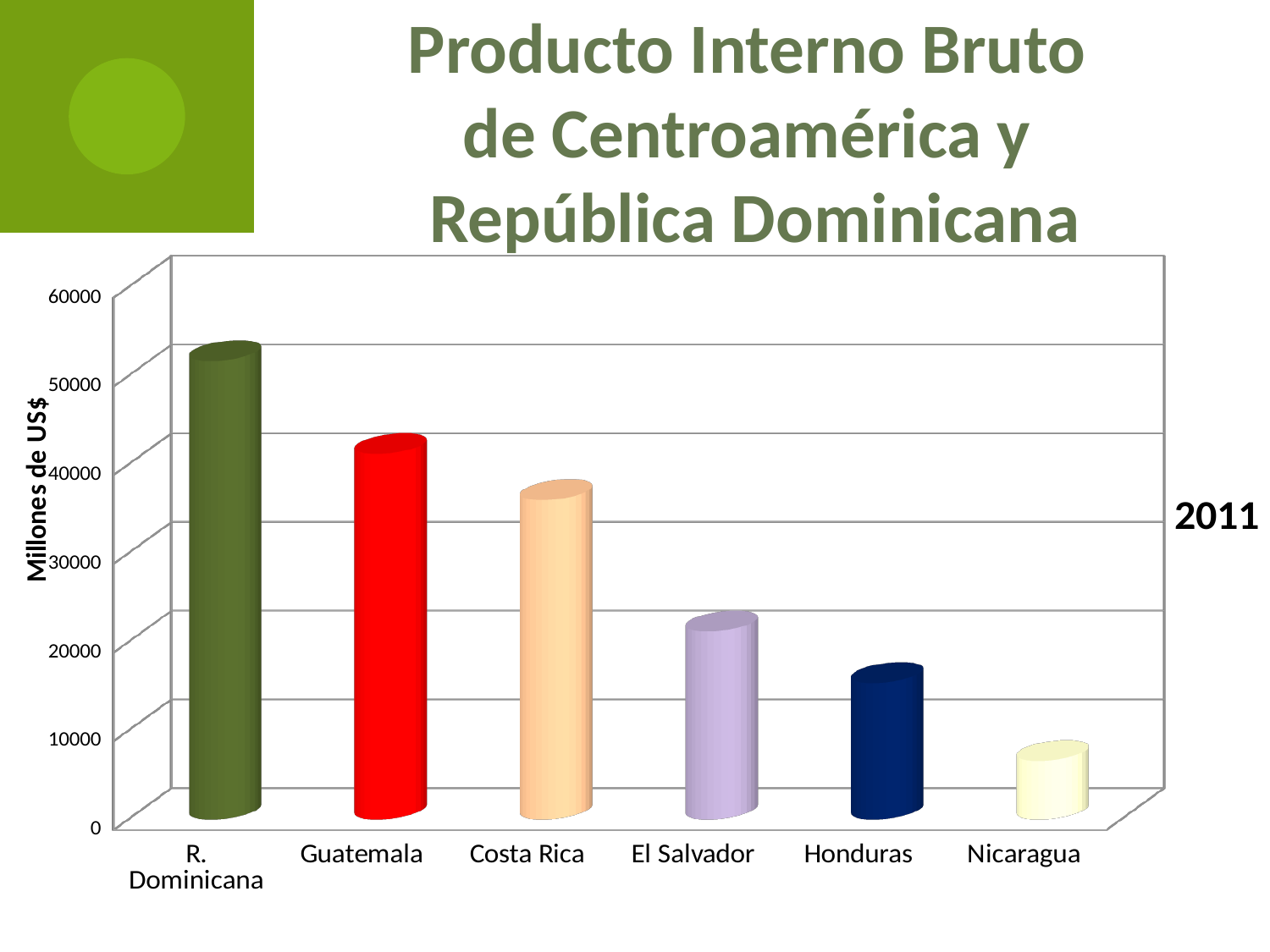
How many countries are shown on the x axis of the chart? 6 Which country has the lowest GDP value in the chart? Nicaragua What year does the legend of the chart show? 2011 Which has the larger value, Guatemala or Costa Rica? Guatemala How many series does the legend list? 1 Is the value for El Salvador greater or less than 30000? less Which country has the highest GDP value in the chart? R. Dominicana Which has the larger value, El Salvador or Honduras? El Salvador Is the value for Nicaragua greater or less than 20000? less Is the value for R. Dominicana greater or less than 40000? greater Do the values rise or fall moving from left to right along the x axis? Fall What kind of chart is shown on the slide? Bar chart